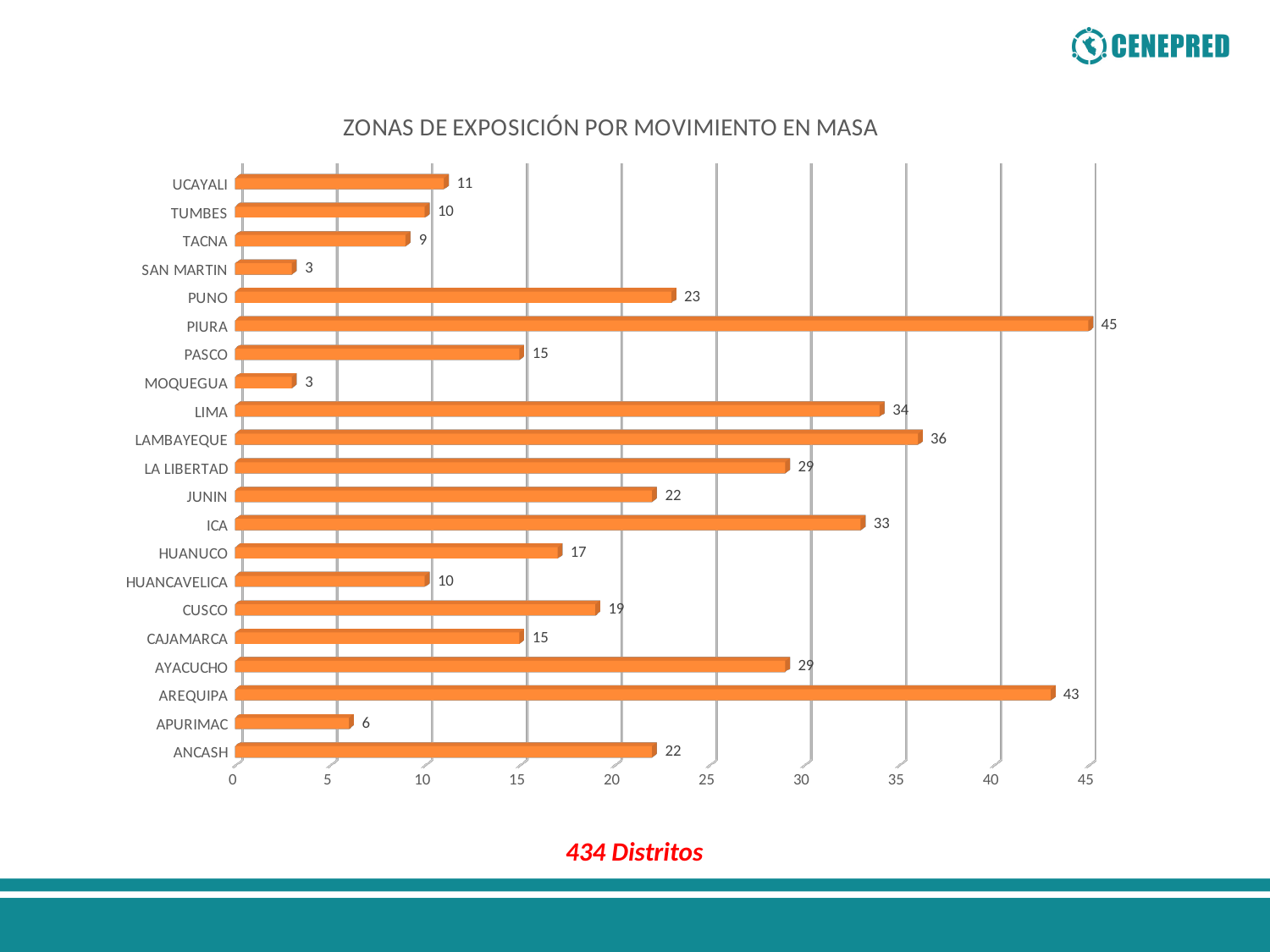
Which regions share the lowest value? SAN MARTIN and MOQUEGUA What is the difference between the values for LAMBAYEQUE and LIMA? 2 Which is larger, the value for ICA or the value for LA LIBERTAD? ICA What kind of chart is this? Bar chart What is the title of the chart? ZONAS DE EXPOSICIÓN POR MOVIMIENTO EN MASA How many regions are shown on the chart? 21 Which region has the highest value? PIURA What is the value for PIURA? 45 Is the value for PUNO greater or less than 20? greater What is the value for HUANCAVELICA? 10 What total number of districts is stated below the chart? 434 Distritos What is the value for AREQUIPA? 43